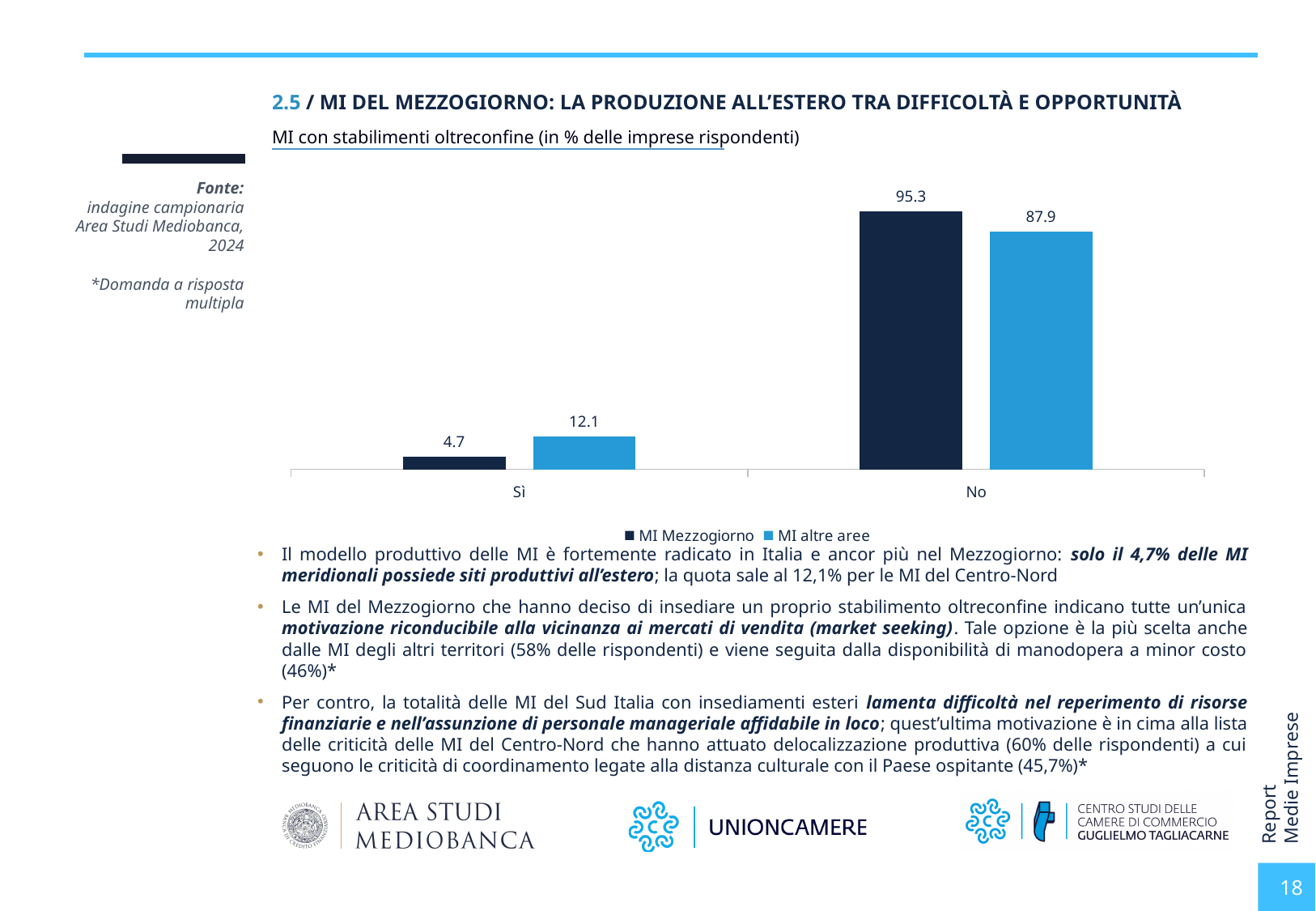
How many series does the legend list? 2 Which category has the lowest value for MI altre aree? Sì What is the value for MI altre aree in the Sì category? 12.1 How many categories are shown on the x axis? 2 What kind of chart is shown on the slide? Bar chart What is the difference between MI Mezzogiorno and MI altre aree in the No category? 7.4 What is the value for MI Mezzogiorno in the No category? 95.3 What is the value for MI altre aree in the No category? 87.9 What is the difference between MI altre aree and MI Mezzogiorno in the Sì category? 7.4 What is the value for MI Mezzogiorno in the Sì category? 4.7 In the No category, which series has the larger value, MI Mezzogiorno or MI altre aree? MI Mezzogiorno Which category has the highest value for MI Mezzogiorno? No